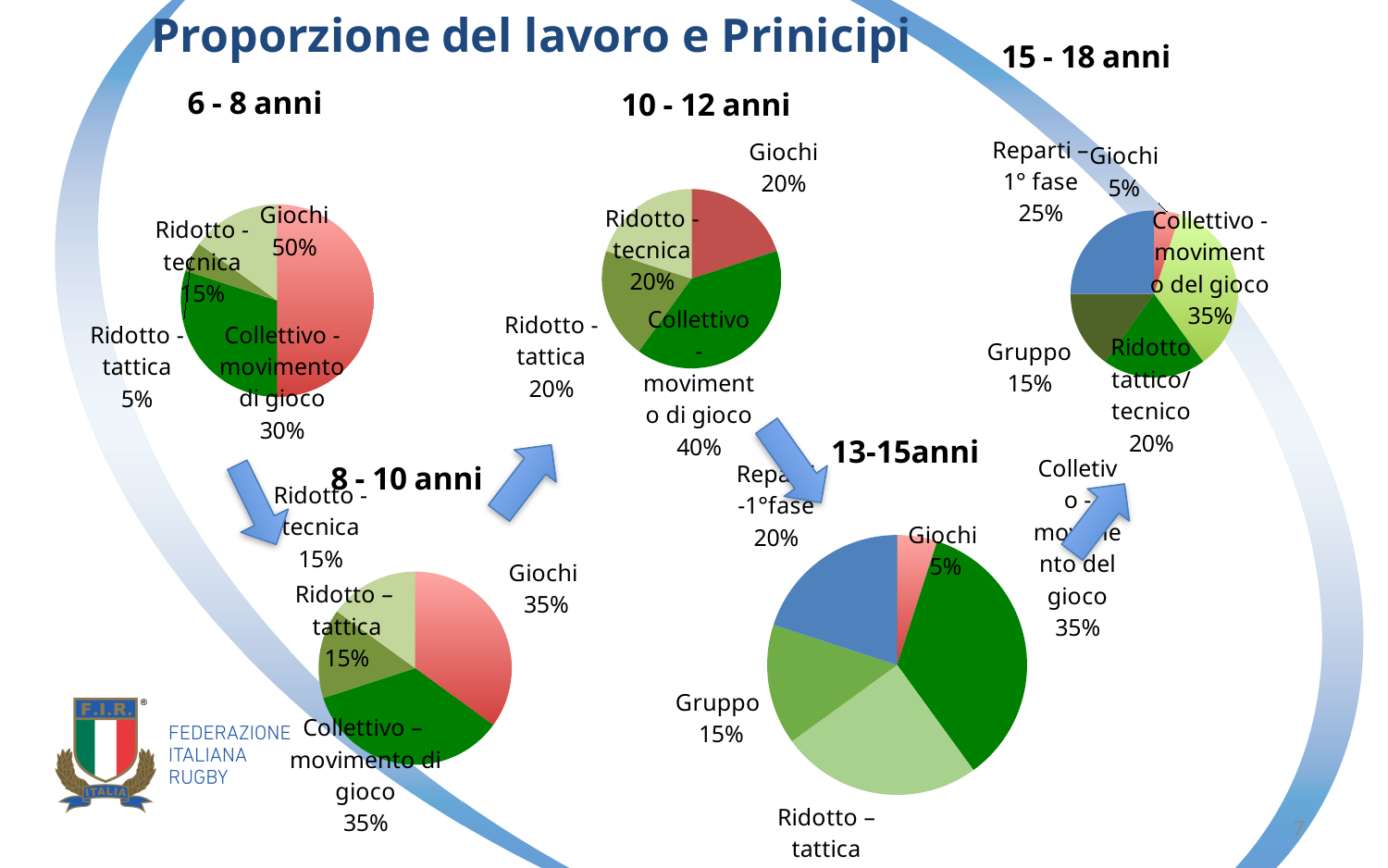
In the 10 - 12 anni pie chart, which category has the largest share? Collettivo - movimento di gioco In the 10 - 12 anni pie chart, what share is Giochi? 20% In the 13-15 anni pie chart, what share is Gruppo? 15% In the 15 - 18 anni pie chart, which category has the largest share? Collettivo - movimento del gioco In the 8 - 10 anni pie chart, what share is Ridotto – tattica? 15% In the 6 - 8 anni pie chart, what share is Giochi? 50% What type of chart is used for each age group on this slide? Pie chart In the 13-15 anni pie chart, which is larger, Reparti -1°fase or Giochi? Reparti -1°fase How many categories does the 8 - 10 anni pie chart show? 4 In the 6 - 8 anni pie chart, what is the difference between the Giochi share and the Collettivo - movimento di gioco share? 20% In the 15 - 18 anni pie chart, what share is Reparti – 1° fase? 25% In the 6 - 8 anni pie chart, which category has the smallest share? Ridotto - tattica